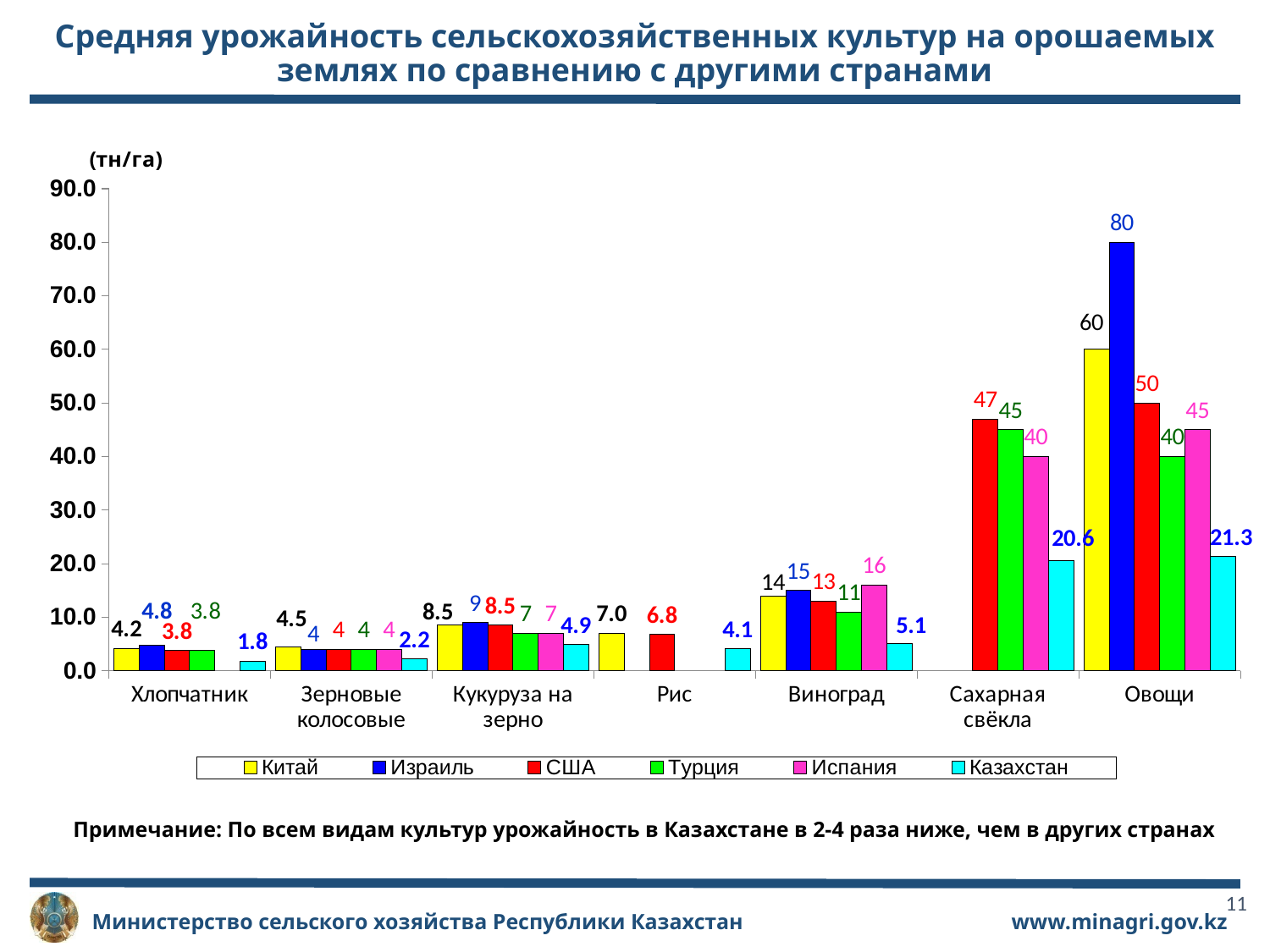
What is the value for Испания in the Виноград category? 16 How many crop categories are shown on the x axis? 7 What type of chart is shown on the slide? bar chart Which country has the highest value in the Овощи category? Израиль What is the value for Казахстан in the Сахарная свёкла category? 20.6 What is the value for Казахстан in the Хлопчатник category? 1.8 How many series does the legend list? 6 What is the value for Израиль in the Овощи category? 80 What is the difference between the values for Израиль and Казахстан in the Овощи category? 58.7 In the Сахарная свёкла category, which is larger: the value for США or the value for Турция? США Which country has the lowest value in the Виноград category? Казахстан What unit is shown above the y axis of the chart? тн/га